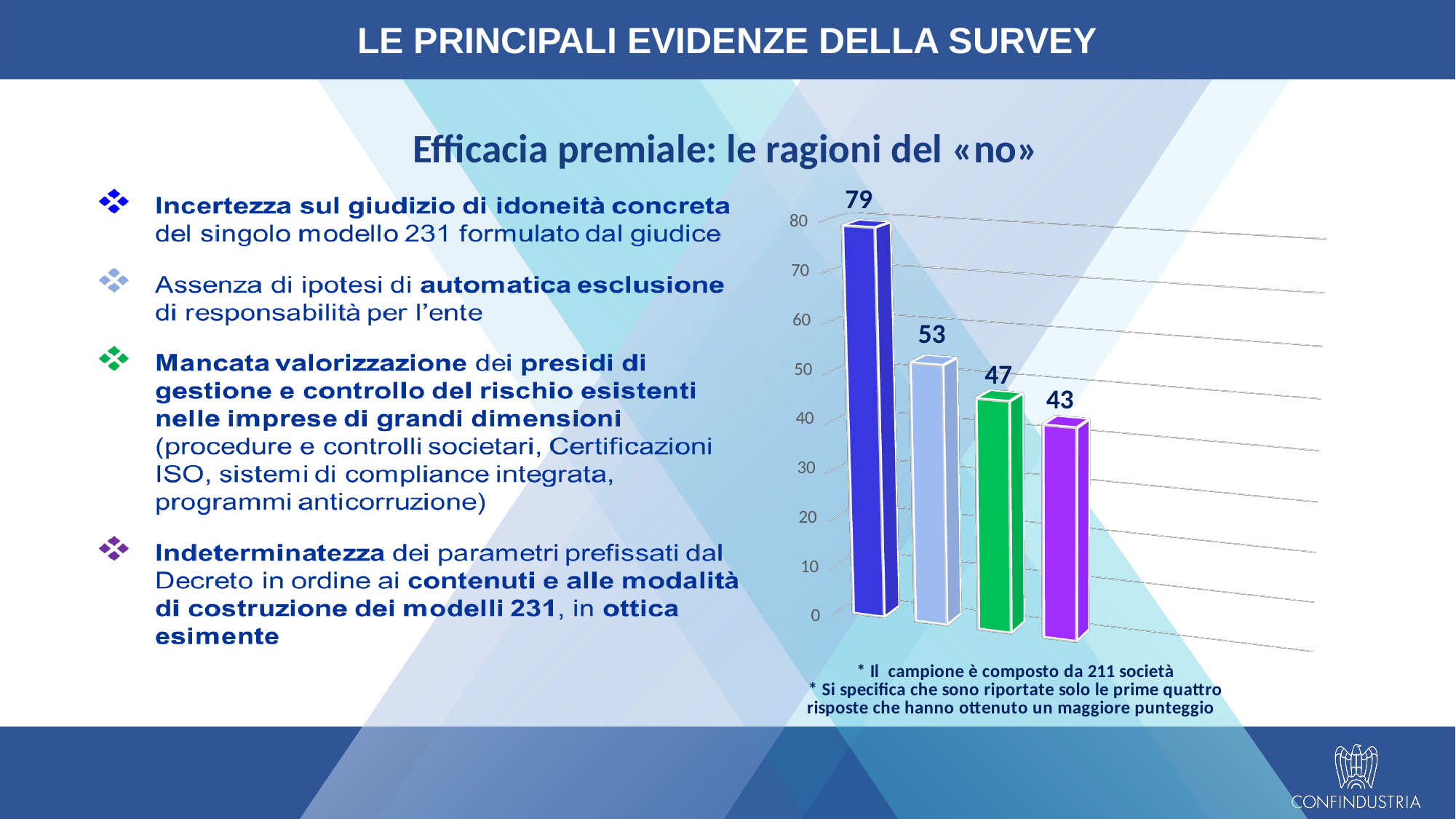
Which bar has the lowest value in the chart? the last (purple) bar, 43 What is the value of the first (dark blue) bar in the chart? 79 What is the value of the second (light blue) bar in the chart? 53 What is the maximum value shown on the vertical axis of the chart? 80 Do the bar values rise or fall from left to right? fall What is the difference between the light blue bar and the green bar? 6 What is the value of the green bar in the chart? 47 What is the value of the purple bar in the chart? 43 What type of chart is shown on the slide? bar chart How many bars are plotted in the chart? 4 Which bar has the highest value in the chart? the first (dark blue) bar, 79 What is the difference between the highest bar (79) and the lowest bar (43)? 36